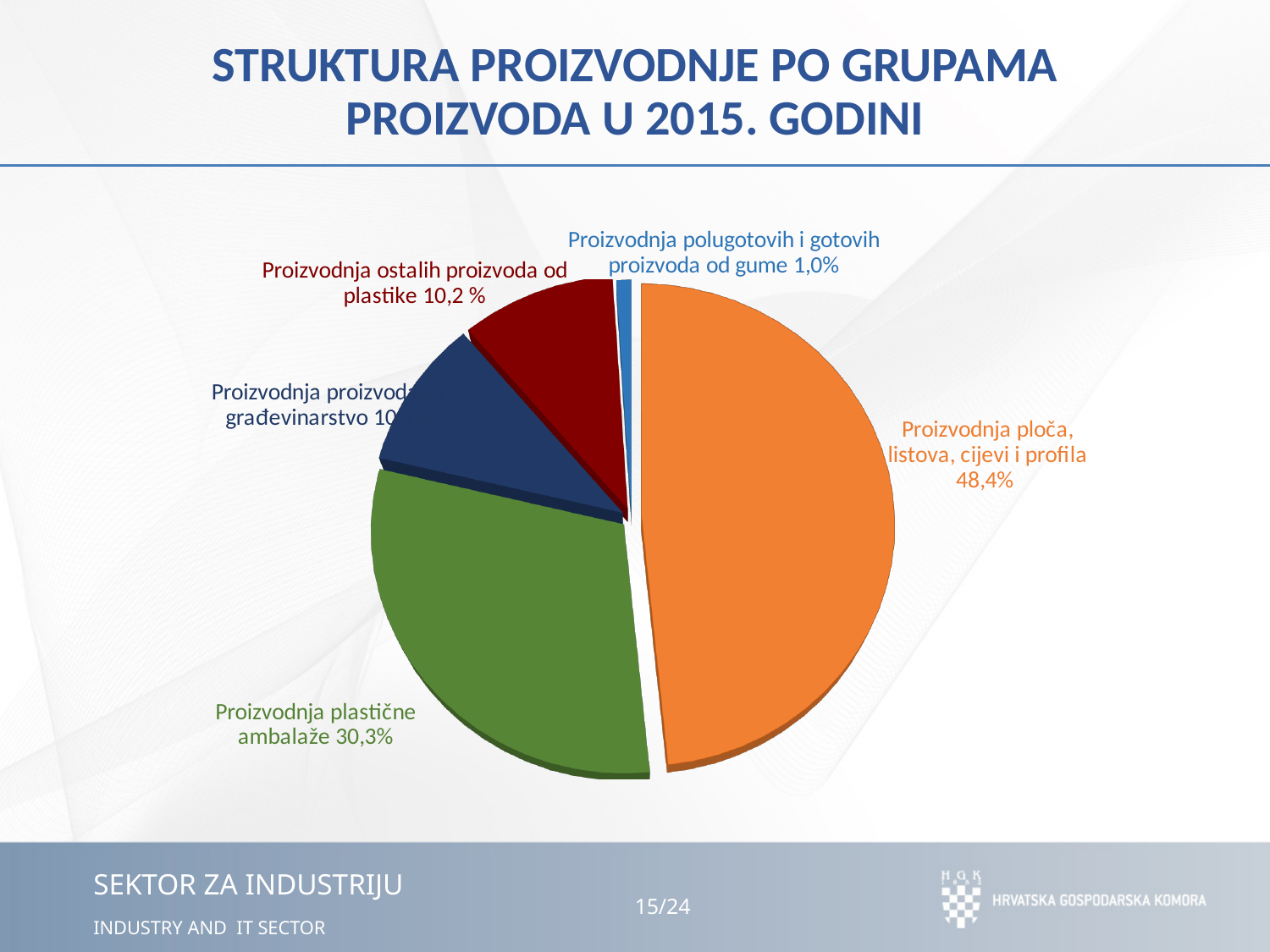
Which product group has the smallest share of production? Proizvodnja polugotovih i gotovih proizvoda od gume How many slices does the pie chart have? 5 What share of production does "Proizvodnja plastične ambalaže" account for? 30,3% What kind of chart is shown on the slide? pie chart Which product group has the largest share of production? Proizvodnja ploča, listova, cijevi i profila What is the difference in percentage points between the share of "Proizvodnja ploča, listova, cijevi i profila" and the share of "Proizvodnja plastične ambalaže"? 18,1 What is the title of the chart on the slide? STRUKTURA PROIZVODNJE PO GRUPAMA PROIZVODA U 2015. GODINI What share of production does "Proizvodnja ploča, listova, cijevi i profila" account for? 48,4% What colour is the slice for "Proizvodnja plastične ambalaže"? green What share of production does "Proizvodnja ostalih proizvoda od plastike" account for? 10,2 % What share of production does "Proizvodnja polugotovih i gotovih proizvoda od gume" account for? 1,0% Which is larger: the share of "Proizvodnja plastične ambalaže" or the share of "Proizvodnja ostalih proizvoda od plastike"? Proizvodnja plastične ambalaže